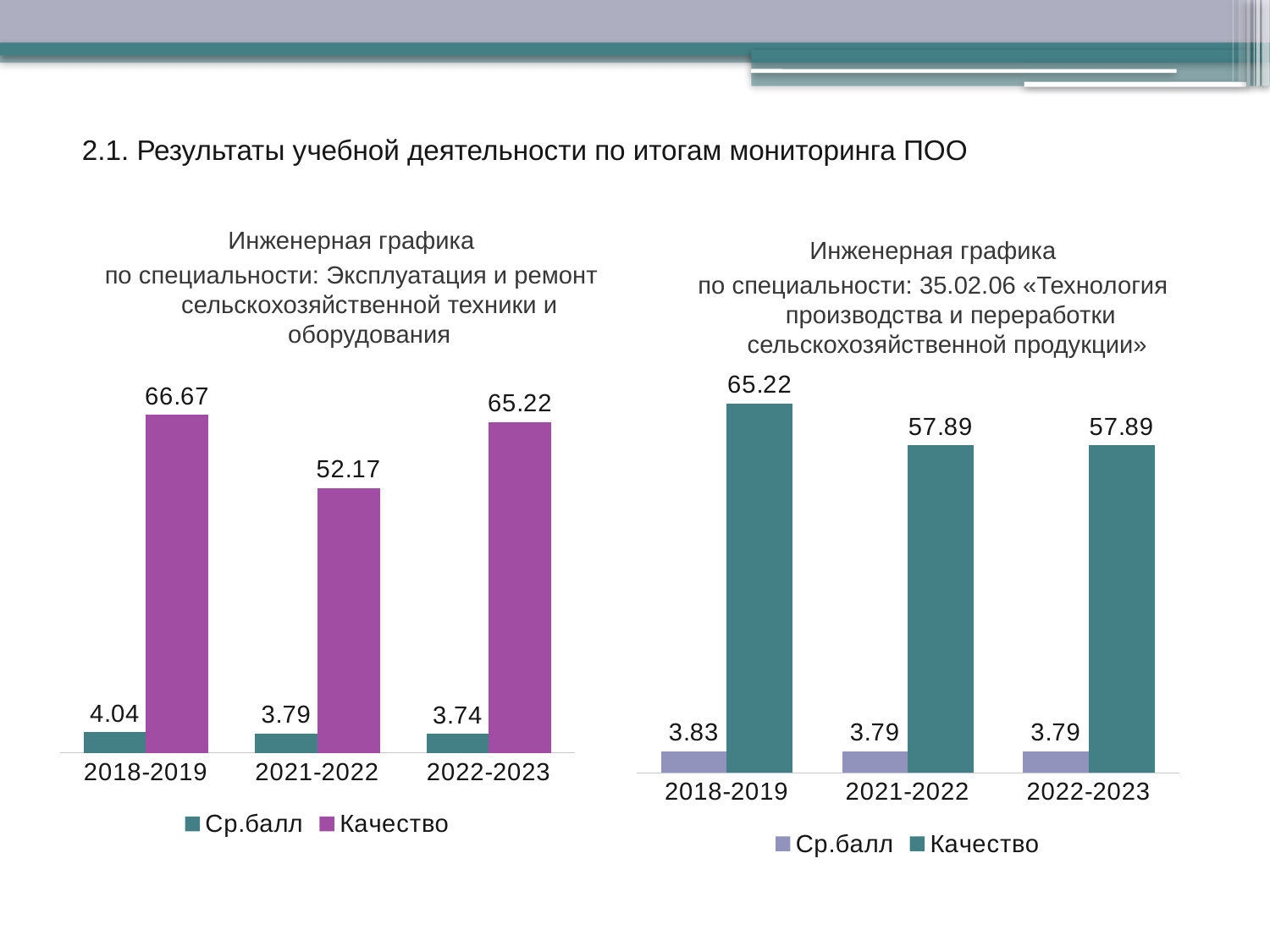
In the left chart (Эксплуатация и ремонт сельскохозяйственной техники и оборудования), what is the difference between the Качество values for 2018-2019 and 2021-2022? 14.5 How many year categories are shown on the x axis of the right chart (35.02.06 «Технология производства и переработки сельскохозяйственной продукции»)? 3 In the right chart (35.02.06 «Технология производства и переработки сельскохозяйственной продукции»), which year has the highest Качество value? 2018-2019 In the right chart (35.02.06 «Технология производства и переработки сельскохозяйственной продукции»), what is the value of Ср.балл for 2018-2019? 3.83 How many series does the legend of the left chart (Эксплуатация и ремонт сельскохозяйственной техники и оборудования) list? 2 In the left chart (Эксплуатация и ремонт сельскохозяйственной техники и оборудования), what is the value of Ср.балл for 2022-2023? 3.74 In the left chart (Эксплуатация и ремонт сельскохозяйственной техники и оборудования), which is larger: the Ср.балл value for 2018-2019 or for 2021-2022? 2018-2019 In the right chart (35.02.06 «Технология производства и переработки сельскохозяйственной продукции»), what is the difference between the Качество values for 2018-2019 and 2022-2023? 7.33 What type of chart is the right chart (35.02.06 «Технология производства и переработки сельскохозяйственной продукции»)? Bar chart In the left chart (Эксплуатация и ремонт сельскохозяйственной техники и оборудования), which year has the lowest Качество value? 2021-2022 In the right chart (35.02.06 «Технология производства и переработки сельскохозяйственной продукции»), what is the value of Качество for 2021-2022? 57.89 In the left chart (Эксплуатация и ремонт сельскохозяйственной техники и оборудования), what is the value of Качество for 2018-2019? 66.67